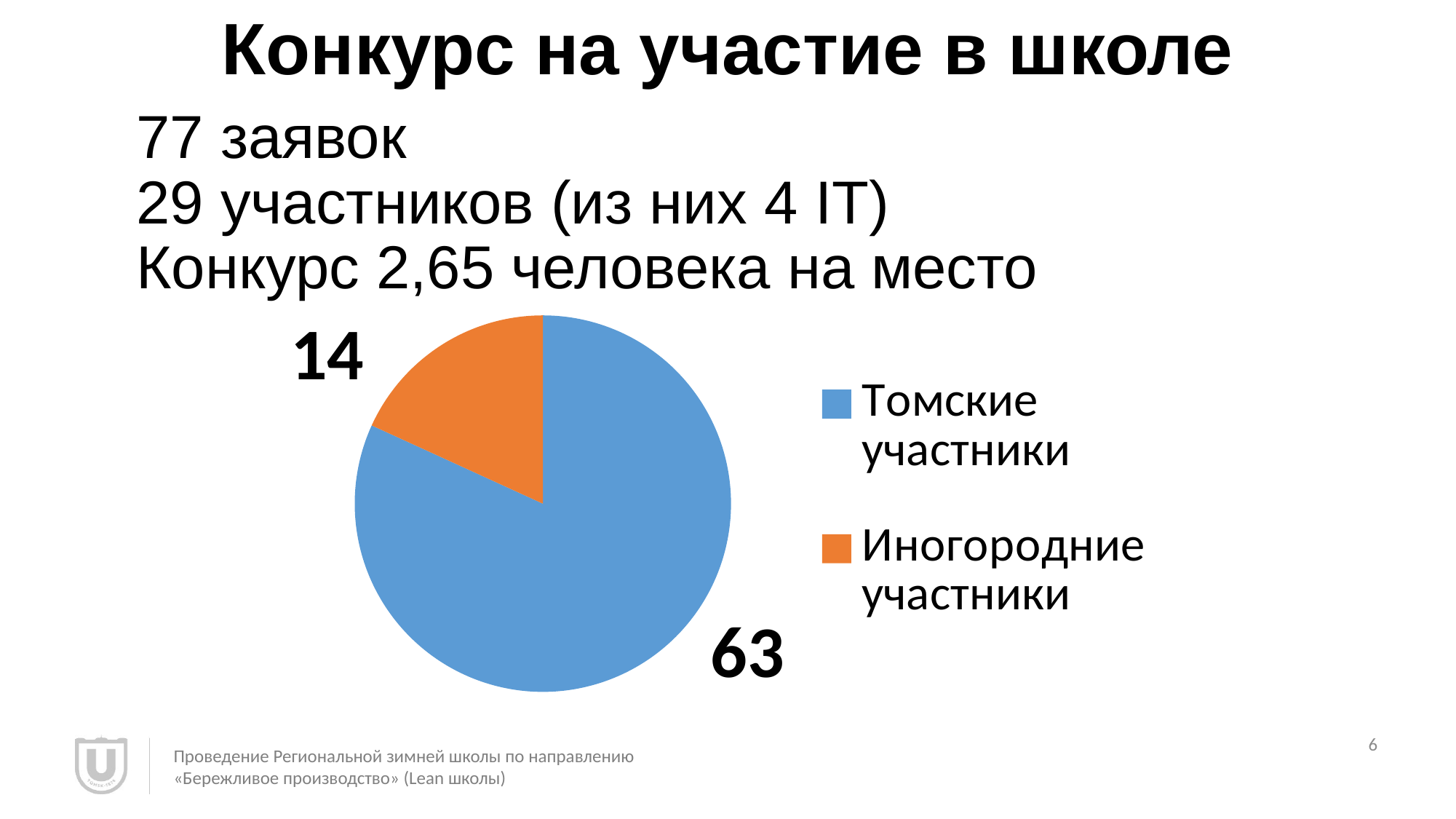
What colour is the slice for Иногородние участники? orange Which is larger: the value for Томские участники or for Иногородние участники? Томские участники Which category has the largest slice of the pie? Томские участники What is the difference between the values for Томские участники and Иногородние участники? 49 What is the total of the two slices in the pie chart? 77 What is the value for Томские участники? 63 What is the value for Иногородние участники? 14 How many slices does the pie chart have? 2 What colour is the slice for Томские участники? blue How many entries does the legend list? 2 Which category has the smallest slice of the pie? Иногородние участники What type of chart is shown on the slide? pie chart